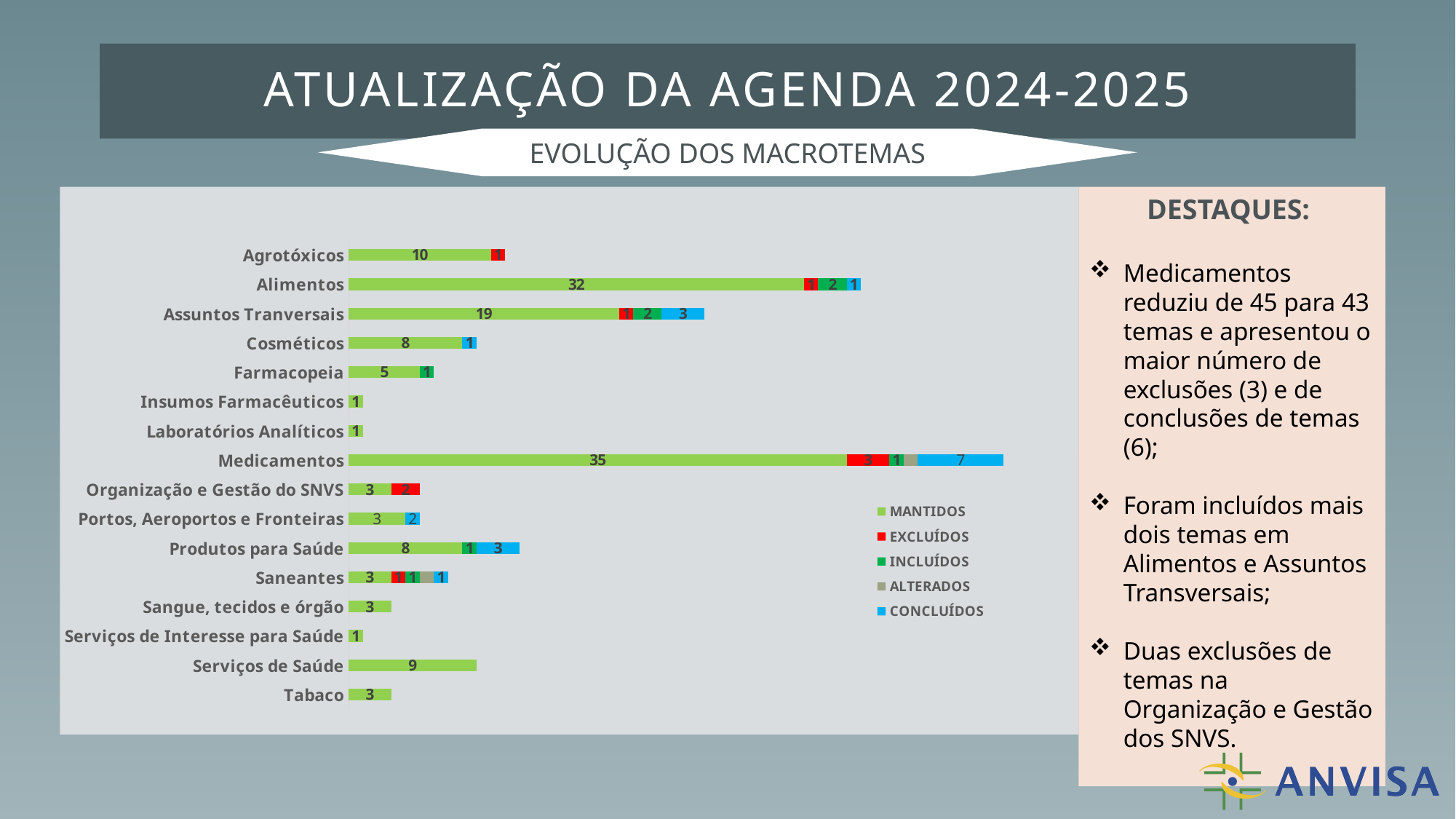
What is the CONCLUÍDOS value for Medicamentos? 7 What kind of chart is shown on the slide? Stacked bar chart What is the difference between the MANTIDOS values for Medicamentos and Alimentos? 3 How many macrotema categories are plotted on the chart? 16 Which category has the highest MANTIDOS value? Medicamentos What is the MANTIDOS value for Medicamentos? 35 Which has a larger MANTIDOS value, Agrotóxicos or Serviços de Saúde? Agrotóxicos What is the total of the stacked bar for Alimentos? 36 What is the MANTIDOS value for Alimentos? 32 What is the MANTIDOS value for Serviços de Saúde? 9 Which colour represents CONCLUÍDOS in the legend? Blue How many series does the chart legend list? 5